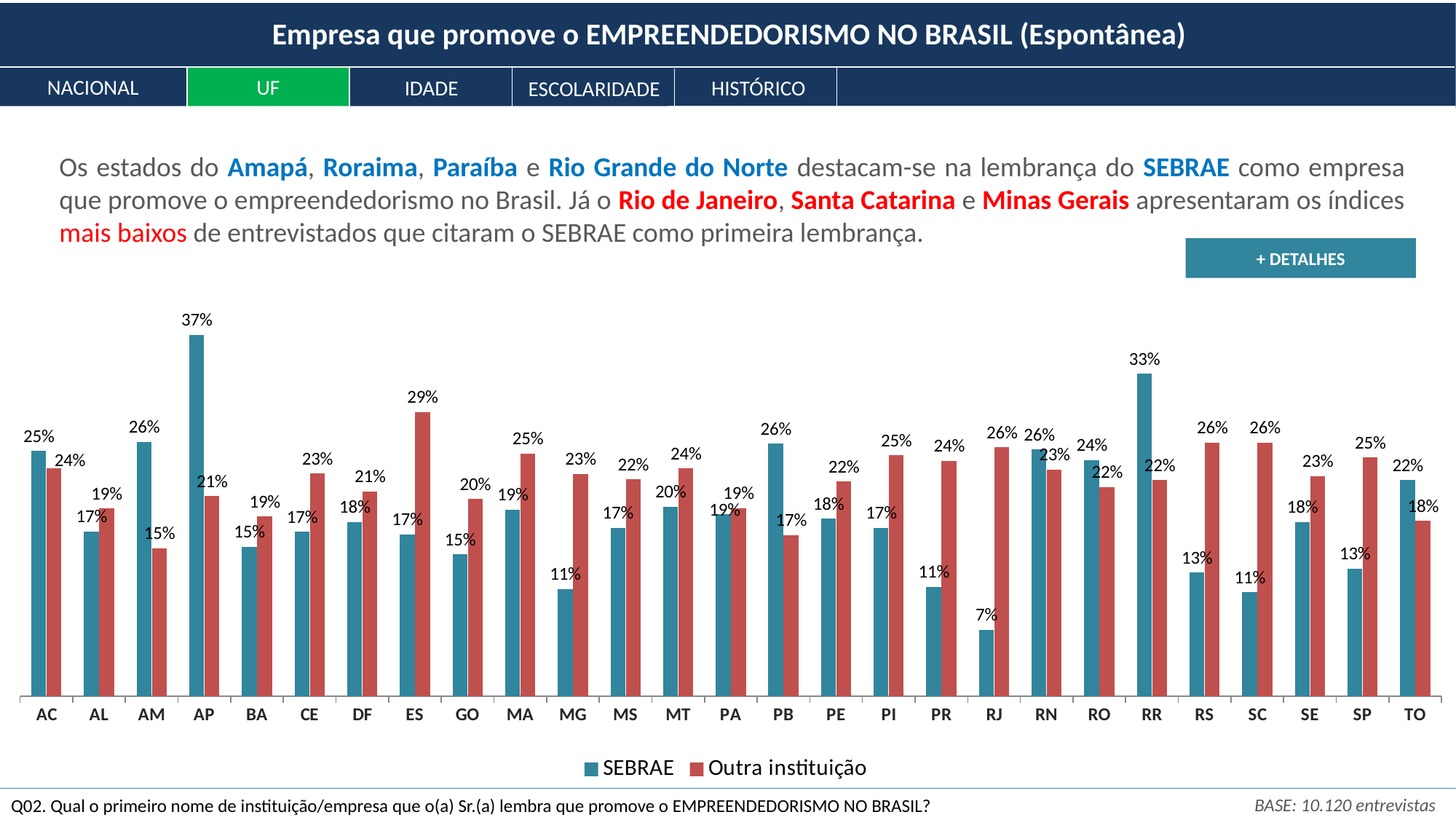
What is the difference between the SEBRAE and Outra instituição values for AP? 16% Which state has the highest SEBRAE value? AP Which state has the highest Outra instituição value? ES Which state has the lowest Outra instituição value? AM Which state has the lowest SEBRAE value? RJ What is the SEBRAE value for RJ? 7% What kind of chart is shown on the slide? Bar chart What is the Outra instituição value for ES? 29% How many states are shown on the x axis? 27 How many series does the legend list? 2 What is the SEBRAE value for AP? 37% For RJ, which is larger: SEBRAE or Outra instituição? Outra instituição